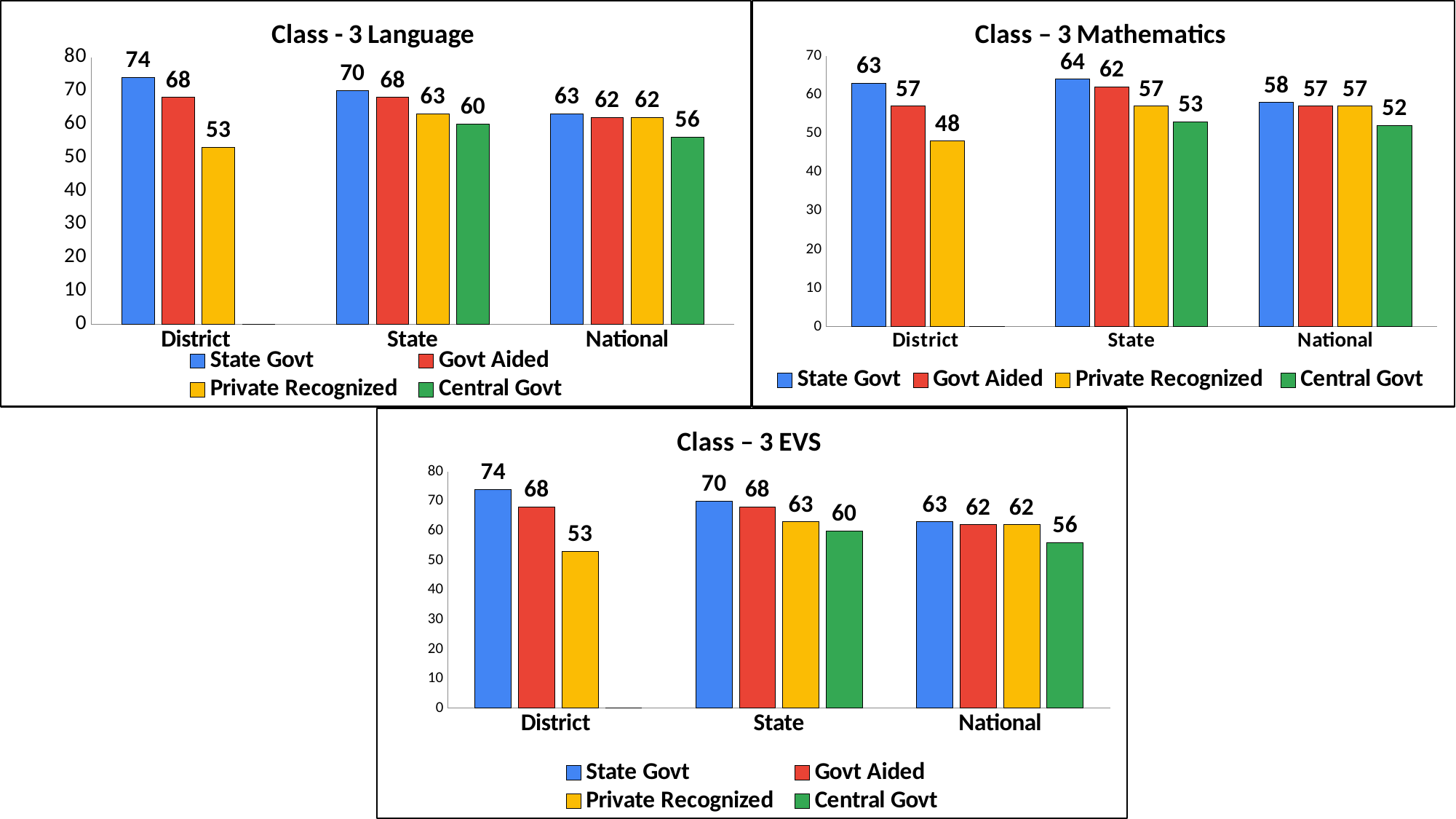
In the 'Class – 3 Mathematics' chart, what is the value for Private Recognized in District? 48 In the 'Class – 3 EVS' chart, what is the value for Central Govt in National? 56 In the 'Class - 3 Language' chart, which school type has the lowest value in District? Private Recognized In the 'Class – 3 Mathematics' chart, what colour represents Govt Aided? Red In the 'Class – 3 Mathematics' chart, which is larger: Central Govt in State or Central Govt in National? Central Govt in State How many categories are shown on the x axis of the 'Class - 3 Language' chart? 3 What kind of chart is 'Class – 3 Mathematics'? Bar chart How many series does the legend of the 'Class – 3 EVS' chart list? 4 In the 'Class – 3 EVS' chart, what is the difference between State Govt in District and State Govt in National? 11 In the 'Class – 3 Mathematics' chart, what is the difference between State Govt and Private Recognized in District? 15 In the 'Class – 3 Mathematics' chart, which school type has the highest value in State? State Govt In the 'Class - 3 Language' chart, what is the value for State Govt in District? 74